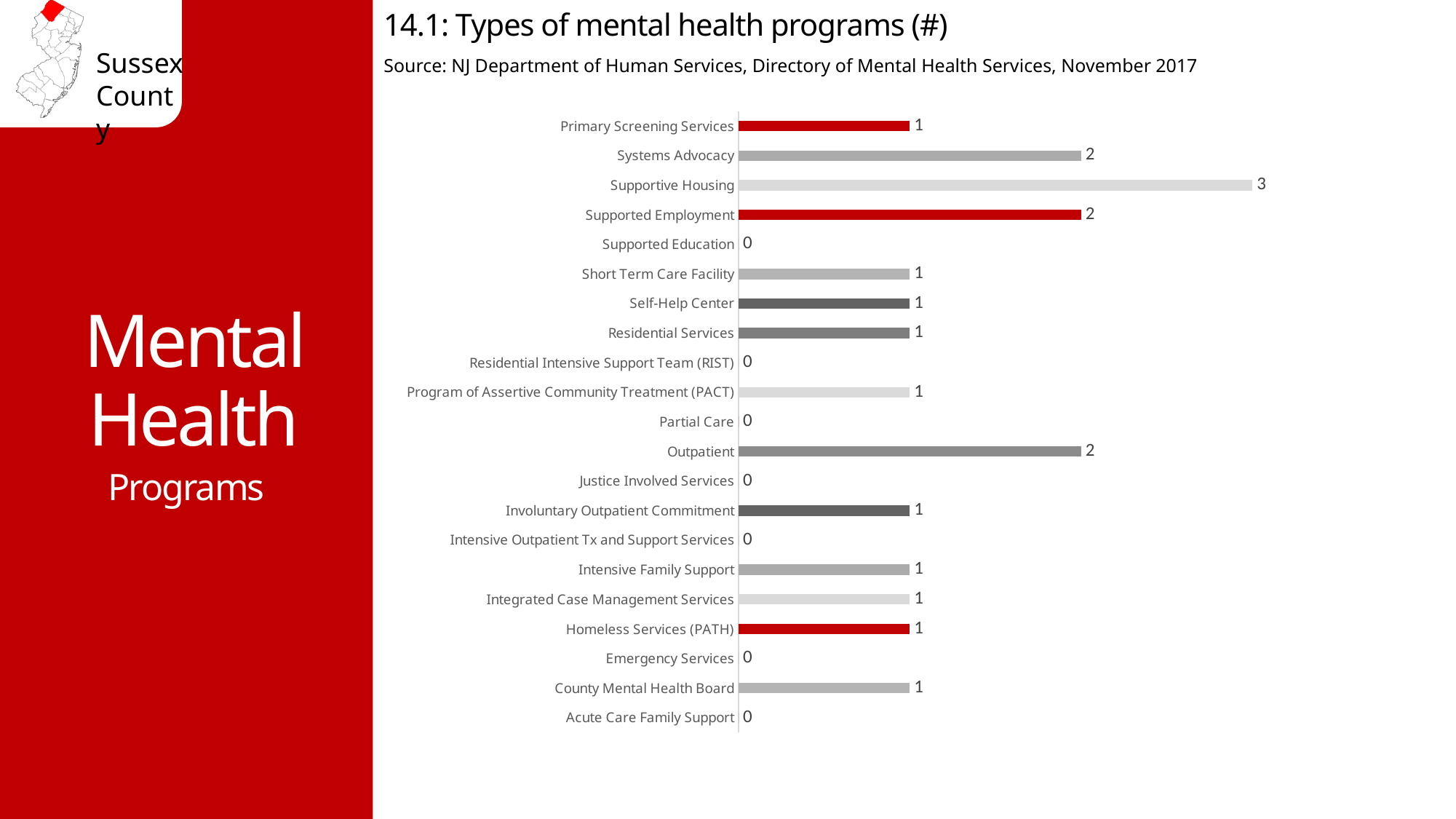
What type of chart is shown on the slide? Bar chart How many categories have a value of 0? 7 What is the value for Homeless Services (PATH)? 1 What is the value for Emergency Services? 0 Which category has the highest value? Supportive Housing Which is larger, the value for Supported Employment or the value for Supported Education? Supported Employment What is the title of the chart? 14.1: Types of mental health programs (#) What is the difference between the values for Supportive Housing and Systems Advocacy? 1 How many categories are shown in the chart? 21 How many categories have a value of 2? 3 What is the value for Outpatient? 2 What is the value for Supportive Housing? 3